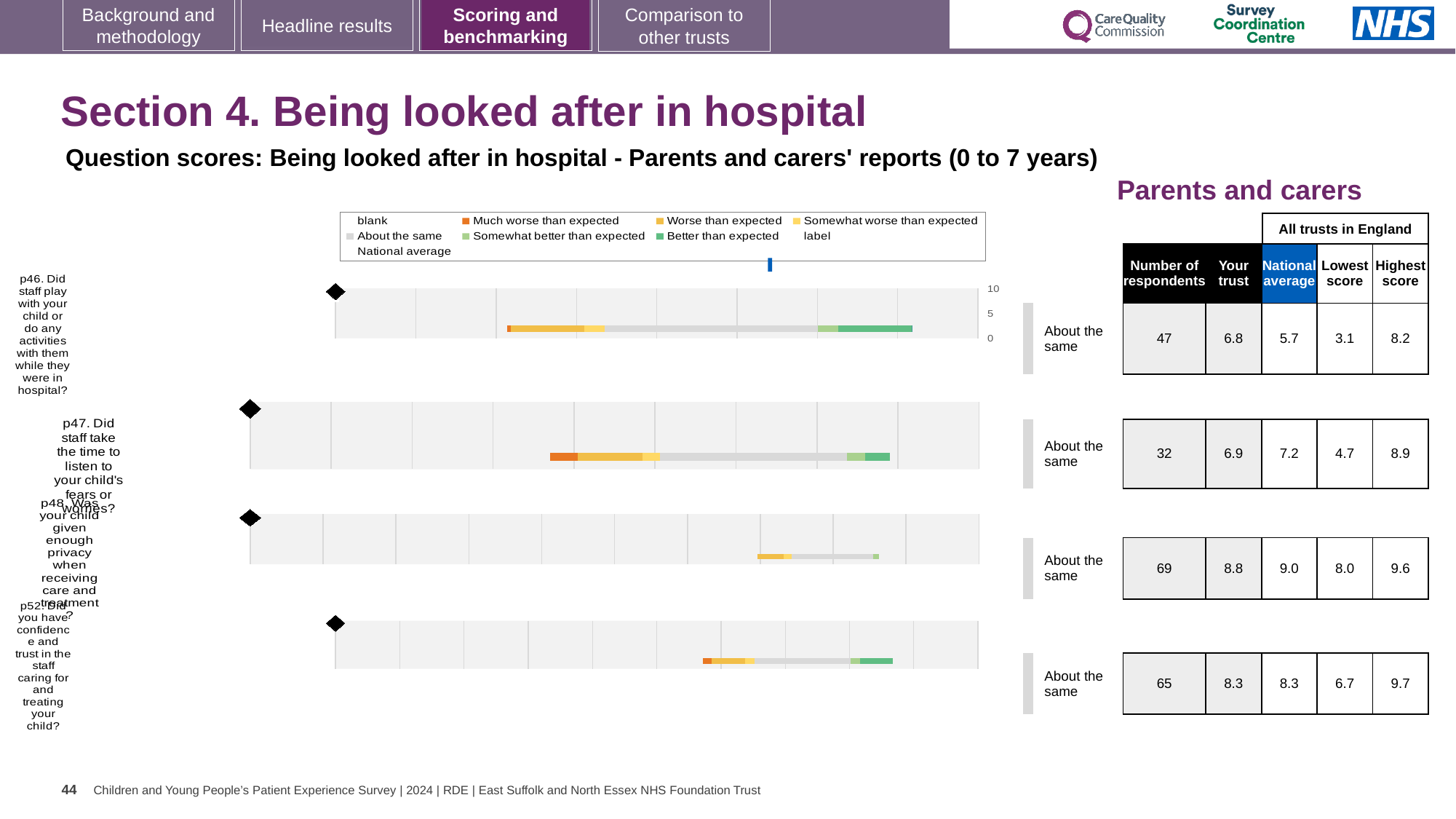
For question p52 (Did you have confidence and trust in the staff caring for and treating your child?), what is the difference between the highest score and the lowest score across all trusts in England? 3.0 For question p48 (Was your child given enough privacy when receiving care and treatment?), how many respondents are shown? 69 For question p47 (Did staff take the time to listen to your child's fears or worries?), what is the national average shown in the table? 7.2 How many question charts (rows) are plotted on the slide? 4 How many entries does the chart legend list? 9 What colour does the legend use for 'Better than expected'? green For question p46 (Did staff play with your child or do any activities with them while they were in hospital?), what is the 'Your trust' score shown in the table? 6.8 What colour does the legend use for 'Much worse than expected'? orange Which question has the highest 'Your trust' score in the table? p48 For question p47, which is larger: the 'Your trust' score or the national average? National average What kind of chart is used to show the question scores on this slide? bar chart Which question has the lowest 'Your trust' score in the table? p46